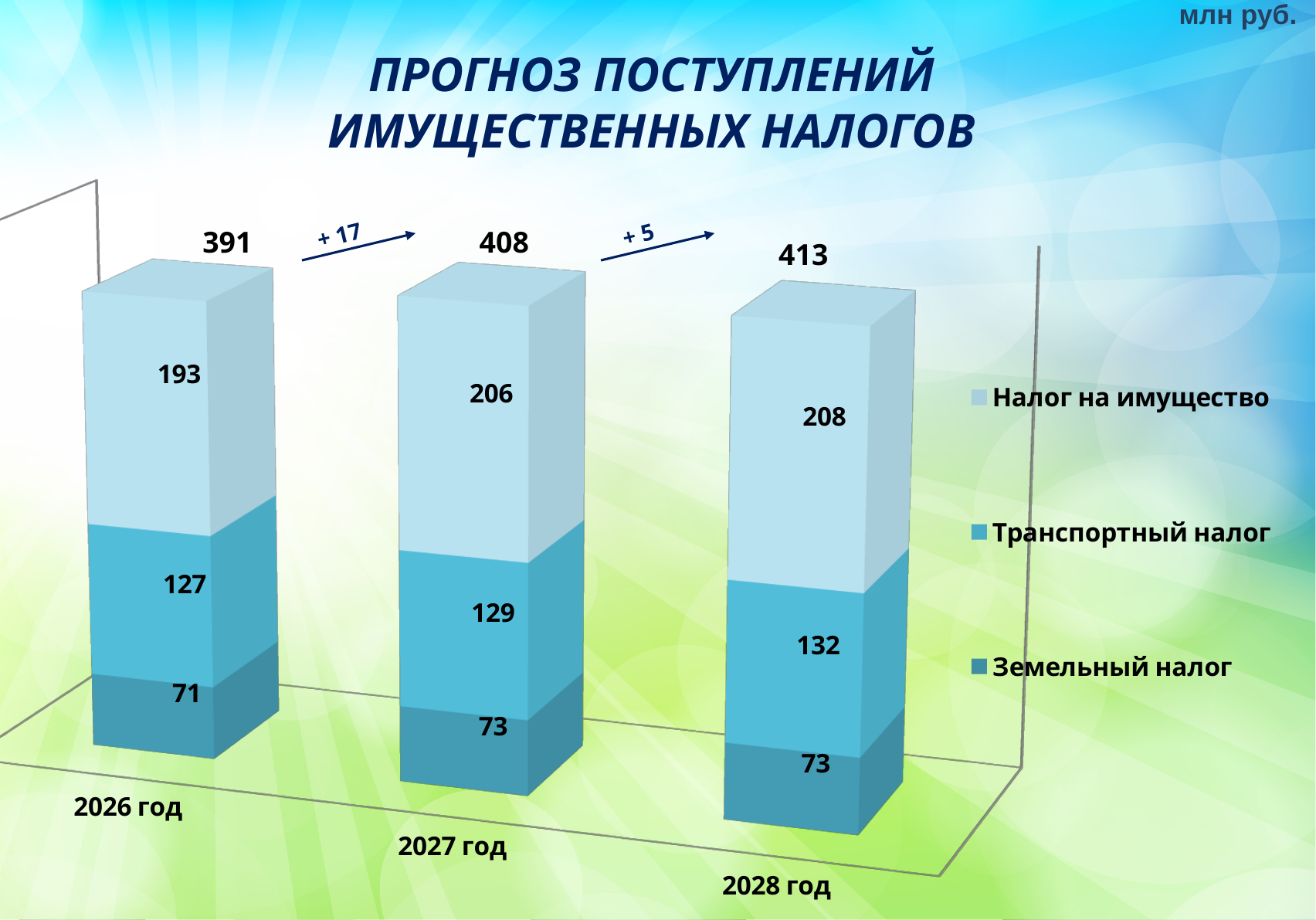
Which year has the lowest total? 2026 год What is the difference between the totals for 2027 год and 2026 год? 17 What is the total of the stacked bar for 2027 год? 408 What is the value of Земельный налог for 2027 год? 73 How many series does the legend list? 3 What kind of chart is shown? Stacked bar chart Which is larger: Транспортный налог in 2026 год or Транспортный налог in 2028 год? Транспортный налог in 2028 год Which year has the highest total? 2028 год Do the totals rise or fall from 2026 год to 2028 год? Rise What is the value of Налог на имущество for 2026 год? 193 How many years are shown on the x axis? 3 What is the value of Транспортный налог for 2028 год? 132